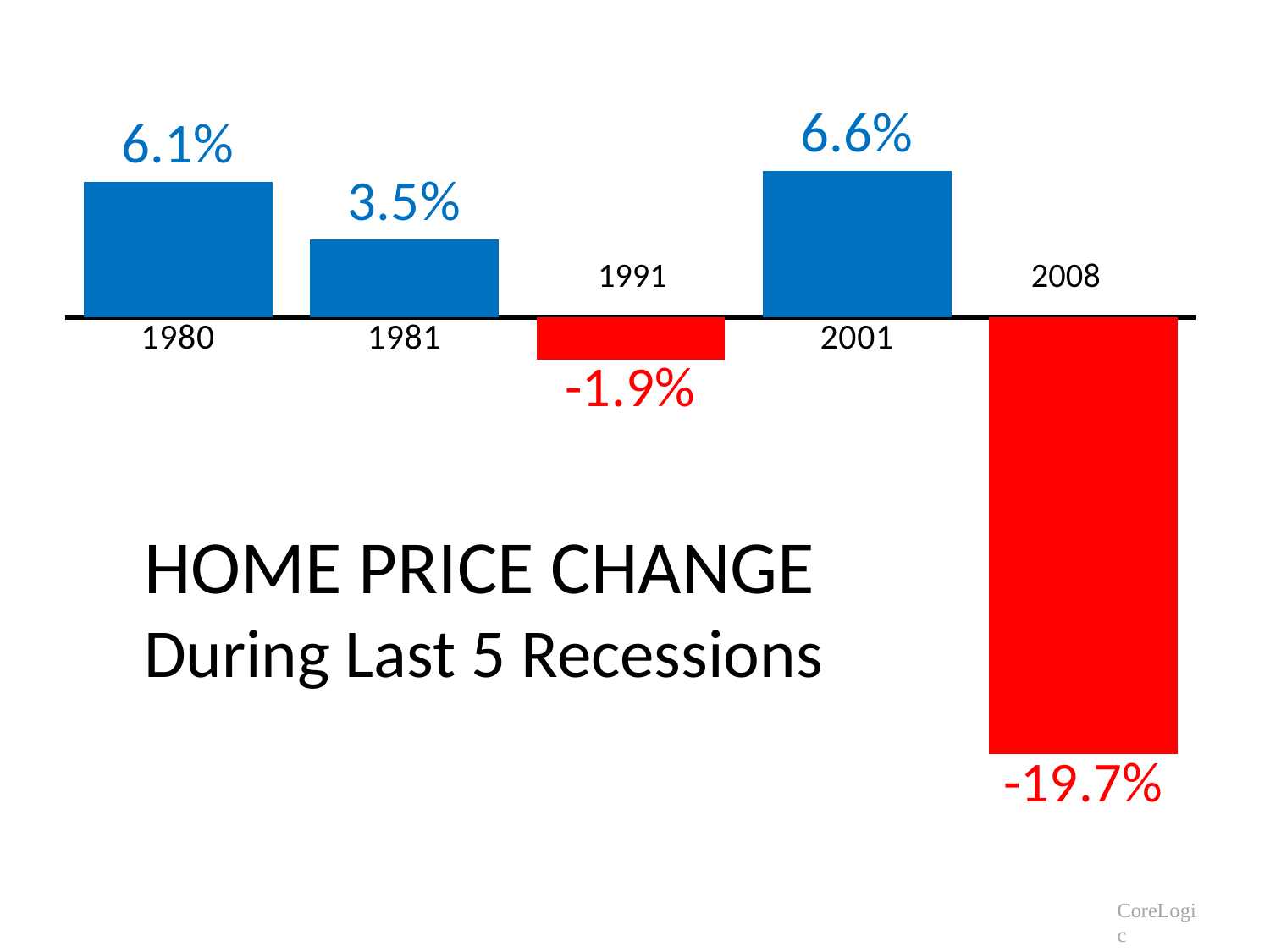
Which recession year shows the highest home price change? 2001 What was the home price change during the 1991 recession? -1.9% What is the title of the chart? HOME PRICE CHANGE During Last 5 Recessions How many recessions show a negative home price change? 2 What colour are the bars for recessions with negative home price changes? Red How many recessions are shown in the chart? 5 What was the home price change during the 2008 recession? -19.7% What is the difference between the home price change in 2001 and in 1981? 3.1% Which recession had a larger home price change, 1980 or 1981? 1980 What type of chart is shown on the slide? Bar chart Which recession year shows the lowest home price change? 2008 What was the home price change during the 1980 recession? 6.1%